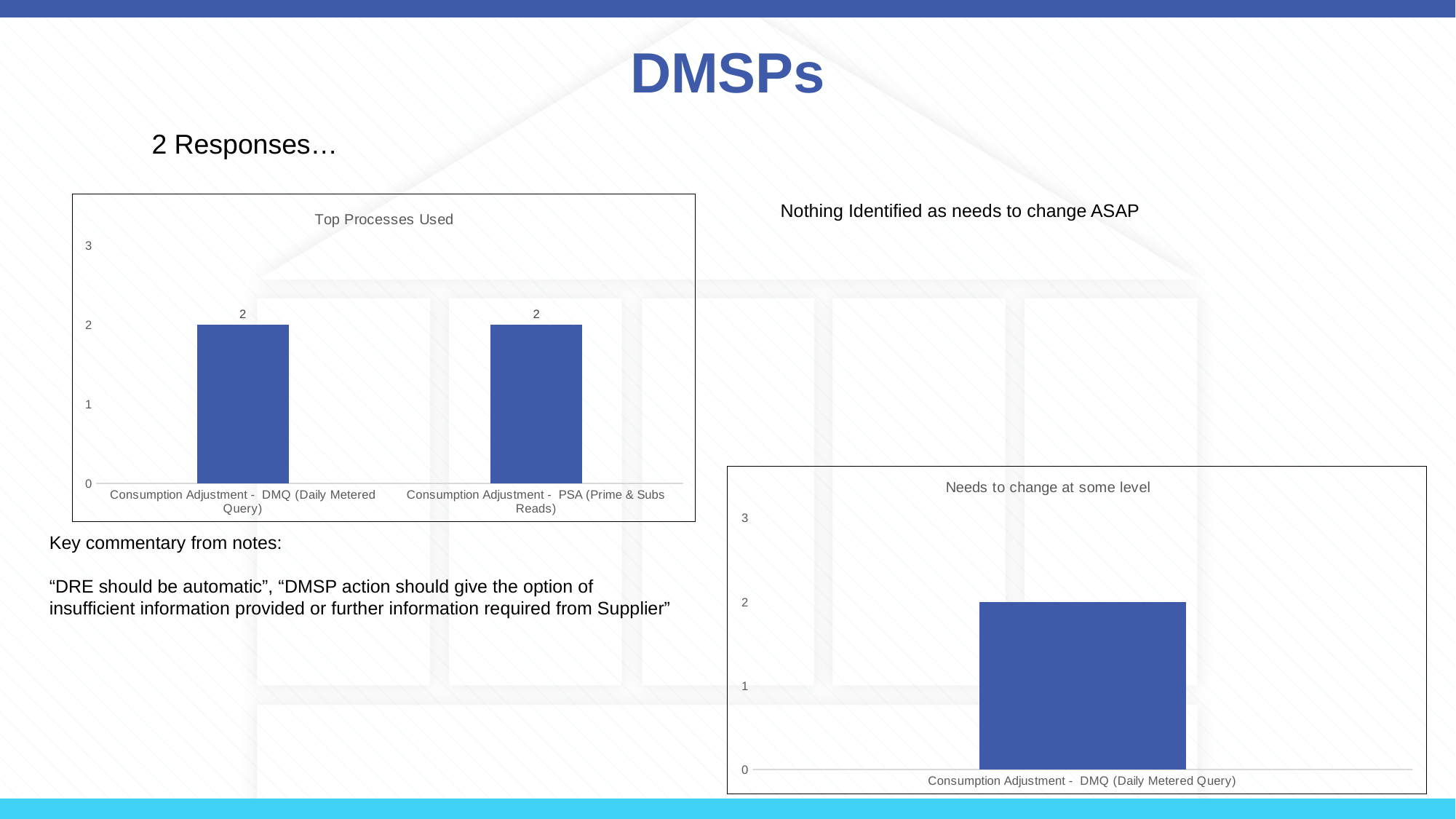
In the 'Top Processes Used' chart, is the value for Consumption Adjustment - PSA (Prime & Subs Reads) greater or less than 3? less In the 'Needs to change at some level' chart, how many categories are plotted? 1 In the 'Top Processes Used' chart, is the value for Consumption Adjustment - DMQ (Daily Metered Query) greater or less than 1? greater In the 'Top Processes Used' chart, what is the difference between the DMQ and PSA values? 0 In the 'Top Processes Used' chart, what is the value for Consumption Adjustment - PSA (Prime & Subs Reads)? 2 In the 'Needs to change at some level' chart, is the value for Consumption Adjustment - DMQ (Daily Metered Query) greater or less than 1? greater In the 'Top Processes Used' chart, what is the value for Consumption Adjustment - DMQ (Daily Metered Query)? 2 What kind of chart is 'Needs to change at some level'? Bar chart In the 'Top Processes Used' chart, how many categories are plotted? 2 What kind of chart is 'Top Processes Used'? Bar chart In the 'Needs to change at some level' chart, which category is shown? Consumption Adjustment - DMQ (Daily Metered Query)